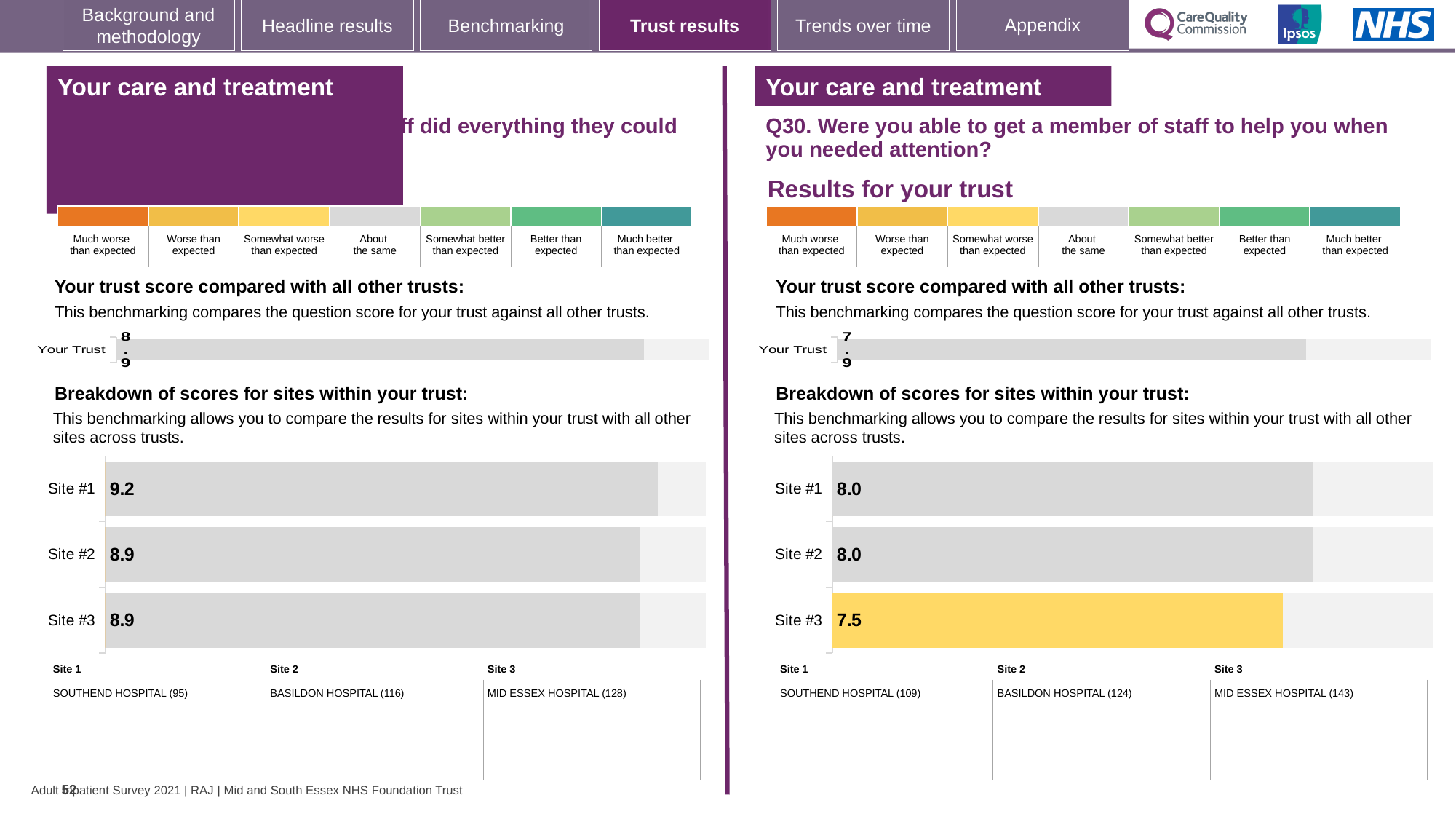
How many sites are shown in the left-hand site breakdown chart? 3 On the left-hand site breakdown chart, which site has the highest score? Site #1 On the right-hand chart (Q30), what is the score for Site #1? 8.0 On the right-hand chart (Q30), what is the difference between the scores for Site #1 and Site #3? 0.5 On the right-hand chart (Q30), what is the score for Site #3? 7.5 On the right-hand chart (Q30), which site's bar is coloured yellow rather than grey? Site #3 On the left-hand site breakdown chart, what is the difference between the scores for Site #1 and Site #2? 0.3 On the right-hand chart (Q30), which is larger: the score for Site #2 or Site #3? Site #2 On the left-hand site breakdown chart, what is the score for Site #1? 9.2 On the right-hand chart (Q30), what is the 'Your Trust' score? 7.9 What kind of chart is used for the breakdown of scores for sites on the right-hand side? Bar chart On the right-hand chart (Q30), which site has the lowest score? Site #3